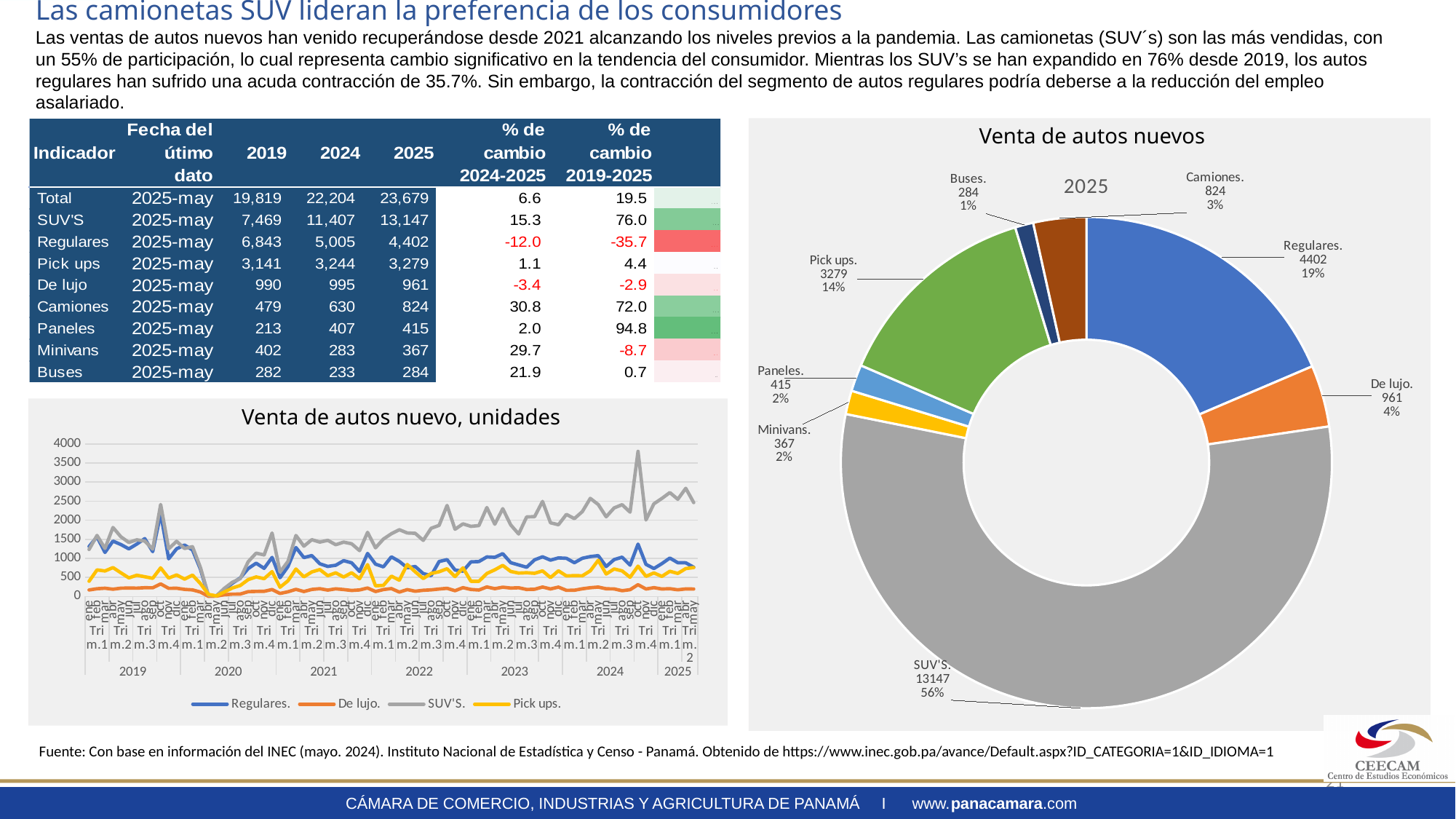
In the line chart 'Venta de autos nuevo, unidades', is the highest peak of the SUV'S series greater or less than 3500? greater In the line chart 'Venta de autos nuevo, unidades', does the SUV'S series generally rise or fall from 2020 to 2025? Rise How many categories are shown in the donut chart 'Venta de autos nuevos'? 8 What type of chart is 'Venta de autos nuevo, unidades' on the left of the slide? Line chart How many series does the legend of the line chart 'Venta de autos nuevo, unidades' list? 4 In the donut chart 'Venta de autos nuevos', which category has the largest slice? SUV'S In the donut chart 'Venta de autos nuevos', what is the value shown for SUV'S? 13147 In the donut chart 'Venta de autos nuevos', which category has the smallest slice? Buses In the donut chart 'Venta de autos nuevos', what is the value shown for Minivans? 367 In the donut chart 'Venta de autos nuevos', what is the difference between the values for Regulares and Pick ups? 1123 In the donut chart 'Venta de autos nuevos', which is larger, the value for Camiones or the value for De lujo? De lujo In the donut chart 'Venta de autos nuevos', what share of the total do Pick ups represent? 14%